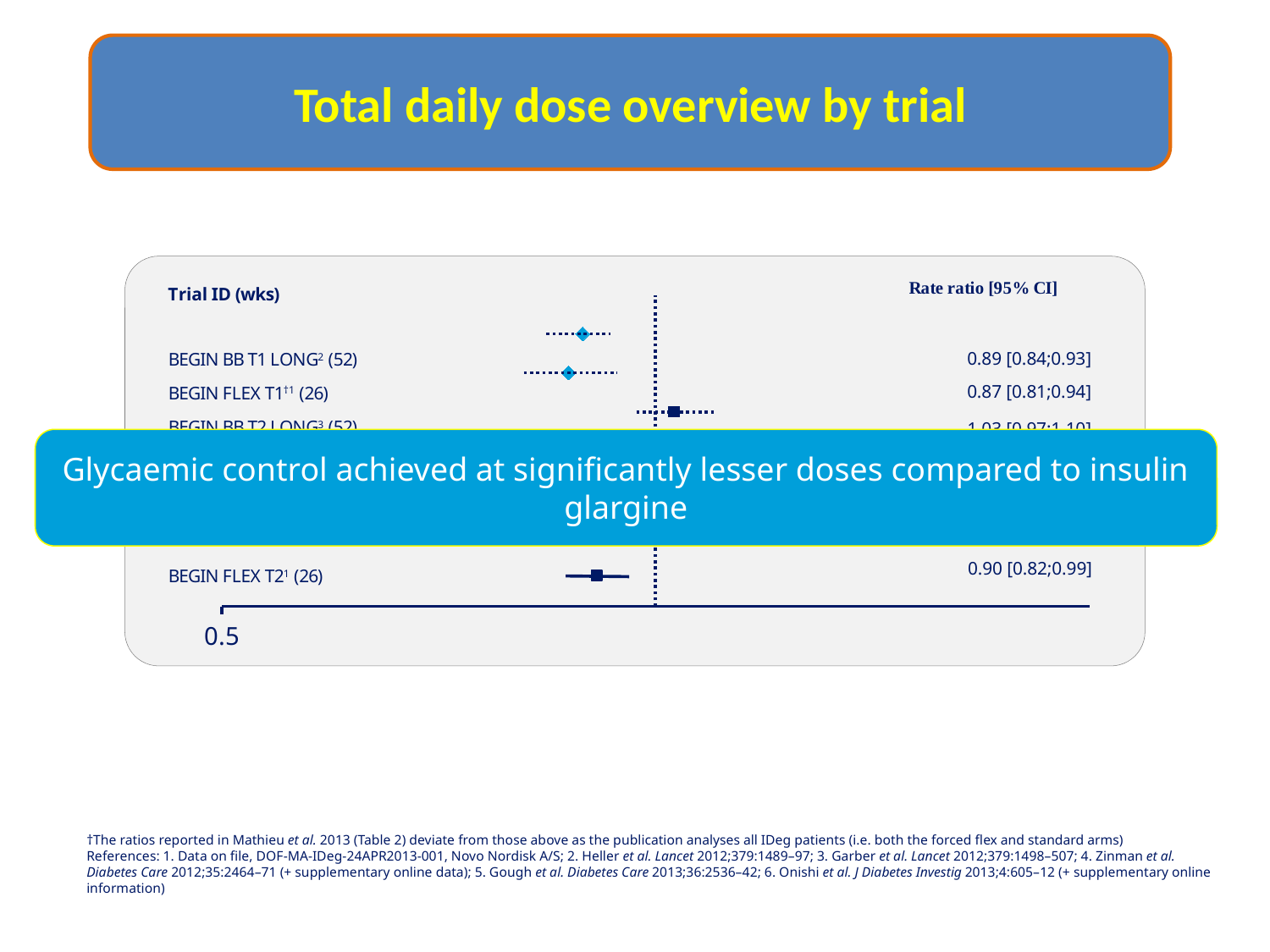
What kind of chart is shown on the slide? Forest plot What is the rate ratio [95% CI] for BEGIN FLEX T1 (26)? 0.87 [0.81;0.94] What is the upper limit of the 95% CI for BEGIN FLEX T2 (26)? 0.99 What is the lower limit of the 95% CI for BEGIN BB T1 LONG (52)? 0.84 What is the title of the slide? Total daily dose overview by trial Is the rate ratio for BEGIN FLEX T1 (26) greater or less than 1? less Which has the larger rate ratio, BEGIN FLEX T1 (26) or BEGIN FLEX T2 (26)? BEGIN FLEX T2 (26) What is the difference between the rate ratios of BEGIN FLEX T2 (26) and BEGIN FLEX T1 (26)? 0.03 What is the rate ratio [95% CI] for BEGIN BB T1 LONG (52)? 0.89 [0.84;0.93] What is the rate ratio [95% CI] for BEGIN FLEX T2 (26)? 0.90 [0.82;0.99] What is the point estimate of the rate ratio for BEGIN FLEX T1 (26)? 0.87 What is the header of the right-hand column of the chart? Rate ratio [95% CI]